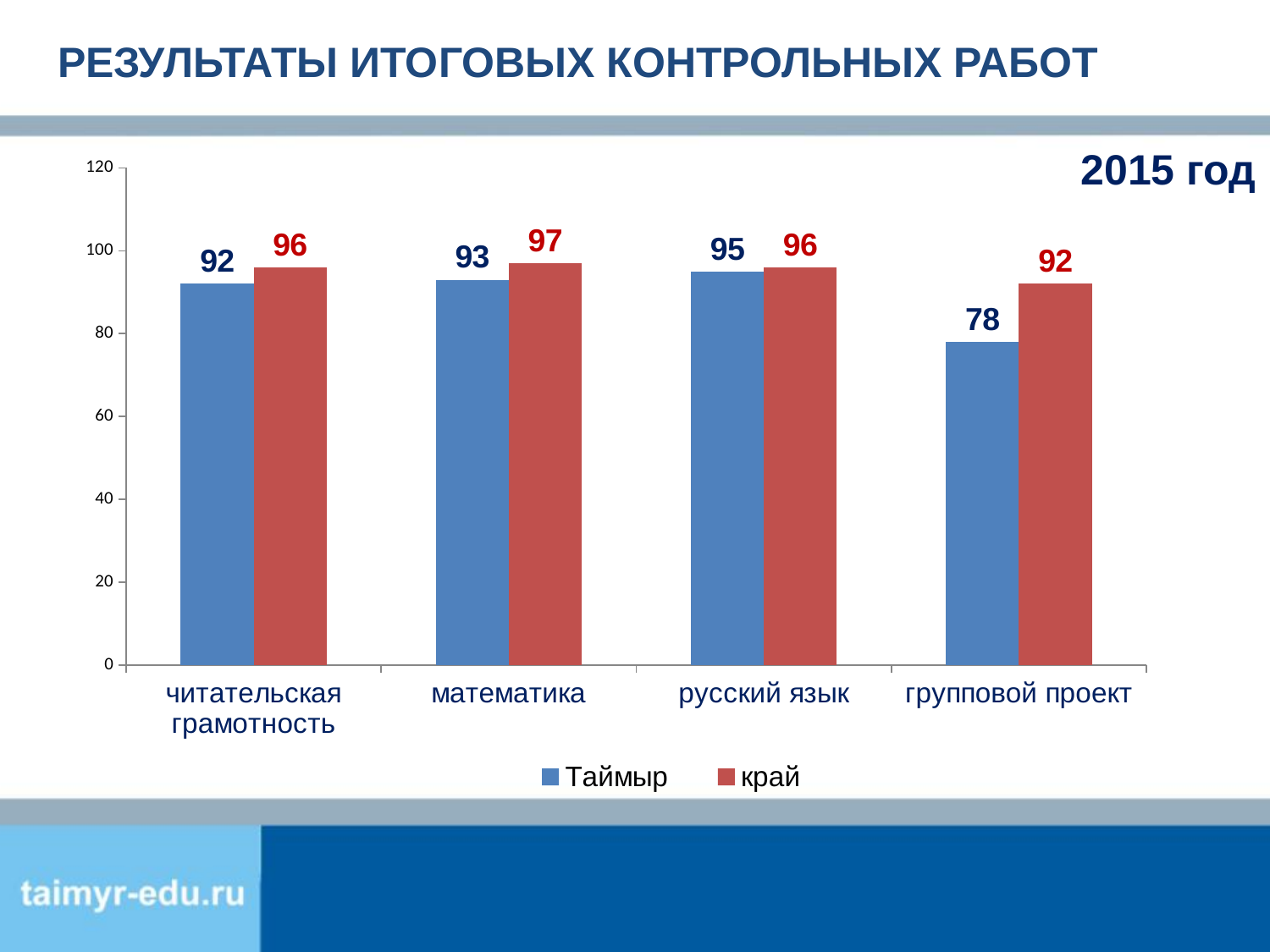
What is the value for край in математика? 97 What is the value for край in русский язык? 96 How many series does the legend list? 2 Is the Таймыр value for групповой проект greater or less than 80? less What kind of chart is shown on the slide? bar chart What is the difference between the край and Таймыр values for групповой проект? 14 In which category is the край value highest? математика What is the value for Таймыр in читательская грамотность? 92 In which category is the Таймыр value lowest? групповой проект How many categories are shown on the x axis? 4 What is the value for Таймыр in групповой проект? 78 Which is larger for математика: the Таймыр value or the край value? край